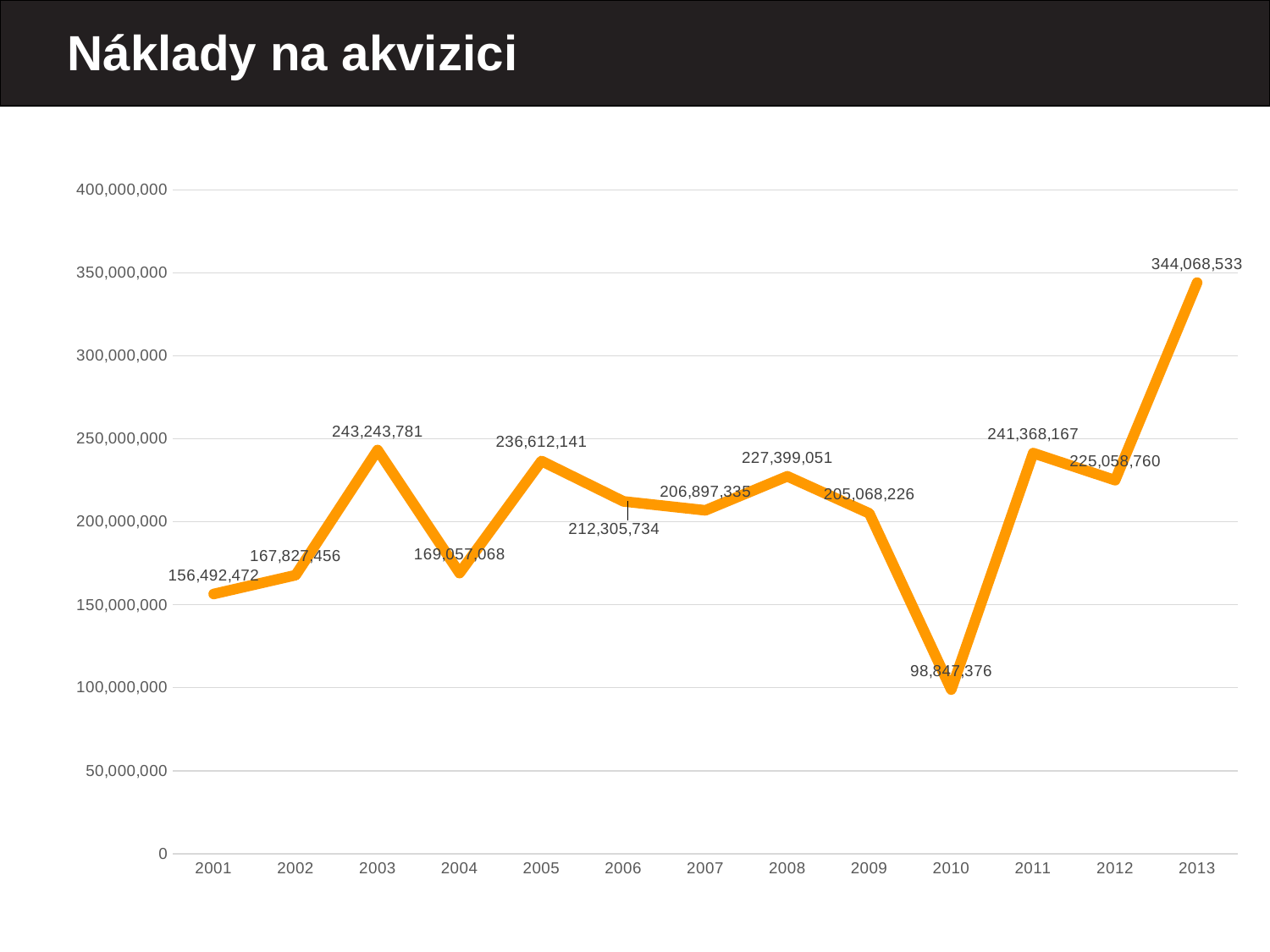
Which is larger, the value for 2005 or the value for 2008? 2005 What kind of chart is shown on the slide? Line chart What is the value for 2010? 98,847,376 What is the value for 2013? 344,068,533 What is the difference between the values for 2013 and 2010? 245,221,157 How many years are plotted on the chart? 13 Which year has the highest value? 2013 What is the value for 2006? 212,305,734 What is the difference between the values for 2003 and 2002? 75,416,325 What is the title of the chart? Náklady na akvizici What is the value for 2003? 243,243,781 Which year has the lowest value? 2010